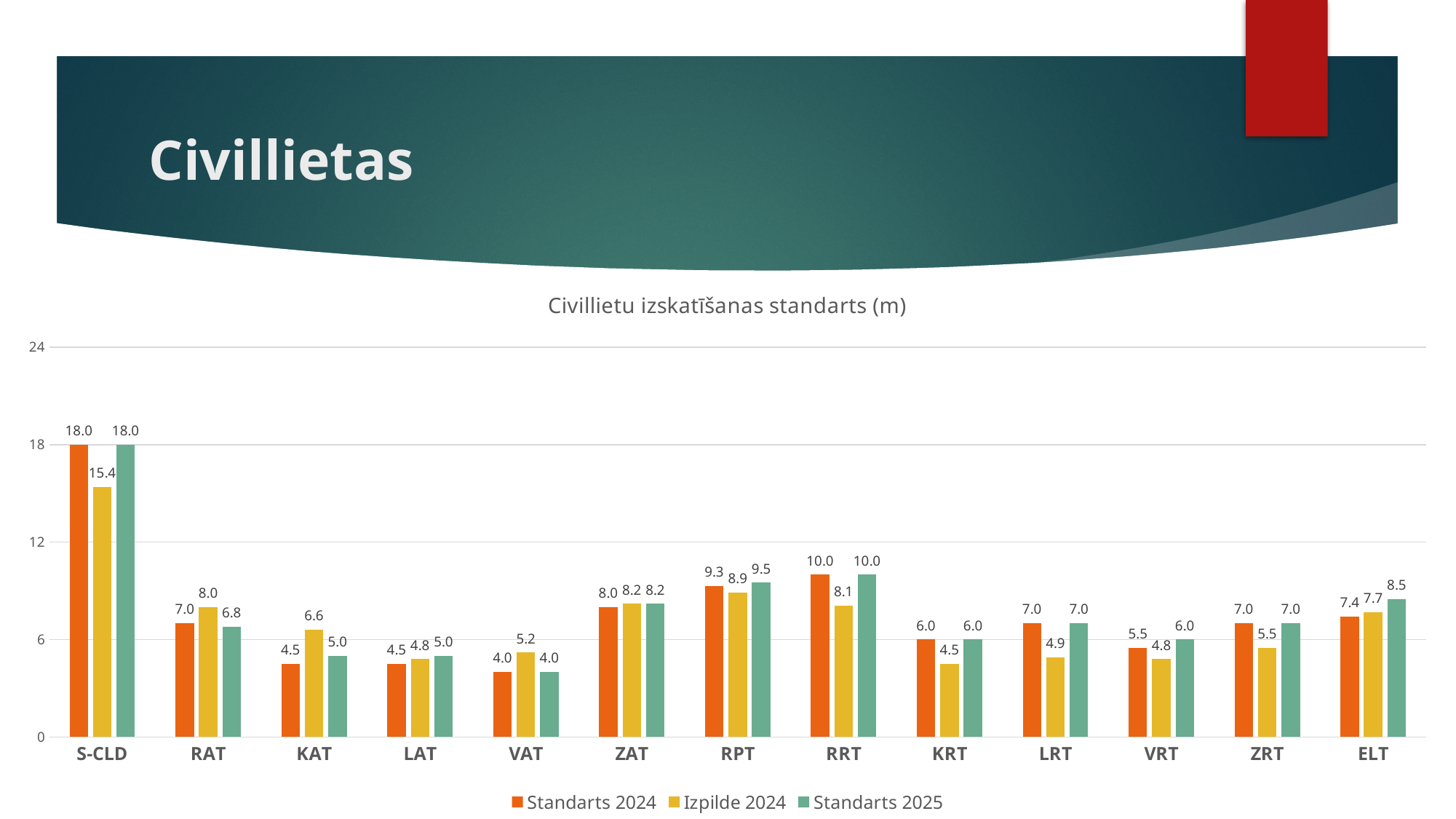
What kind of chart is shown on the slide? Bar chart What is the title of the chart? Civillietu izskatīšanas standarts (m) What is the Standarts 2025 value for ELT? 8.5 Which category has the highest Standarts 2024 value? S-CLD Which is larger for KAT: the Izpilde 2024 value or the Standarts 2025 value? Izpilde 2024 What is the Standarts 2024 value for RPT? 9.3 How many series does the legend list? 3 Which series is shown in orange in the legend? Standarts 2024 What is the Izpilde 2024 value for S-CLD? 15.4 What is the difference between the Standarts 2024 and Izpilde 2024 values for RRT? 1.9 Which category has the lowest Izpilde 2024 value? KRT How many categories are shown on the x axis? 13